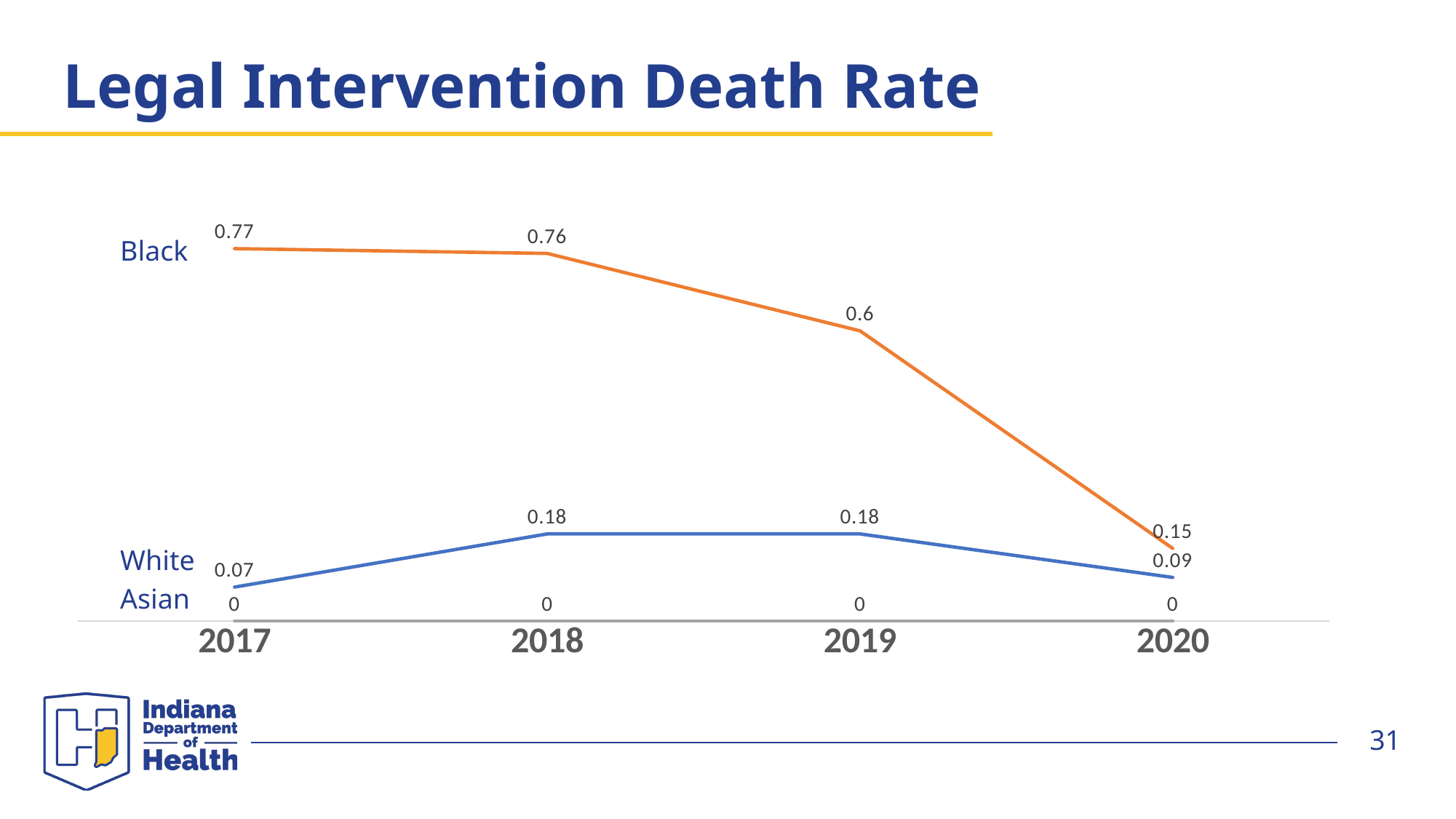
How many groups (series) are plotted on the chart? 3 What is the legal intervention death rate for White in 2018? 0.18 In which year is the Black legal intervention death rate highest? 2017 What kind of chart is shown on the slide? Line chart What is the legal intervention death rate for Black in 2020? 0.15 In which year is the Black legal intervention death rate lowest? 2020 Does the Black death rate rise or fall from 2017 to 2020? Fall Which group has the higher death rate in 2020, Black or White? Black What is the legal intervention death rate for Asian in 2019? 0 How many years are shown on the x axis? 4 What is the legal intervention death rate for Black in 2017? 0.77 What is the difference between the Black and White death rates in 2019? 0.42